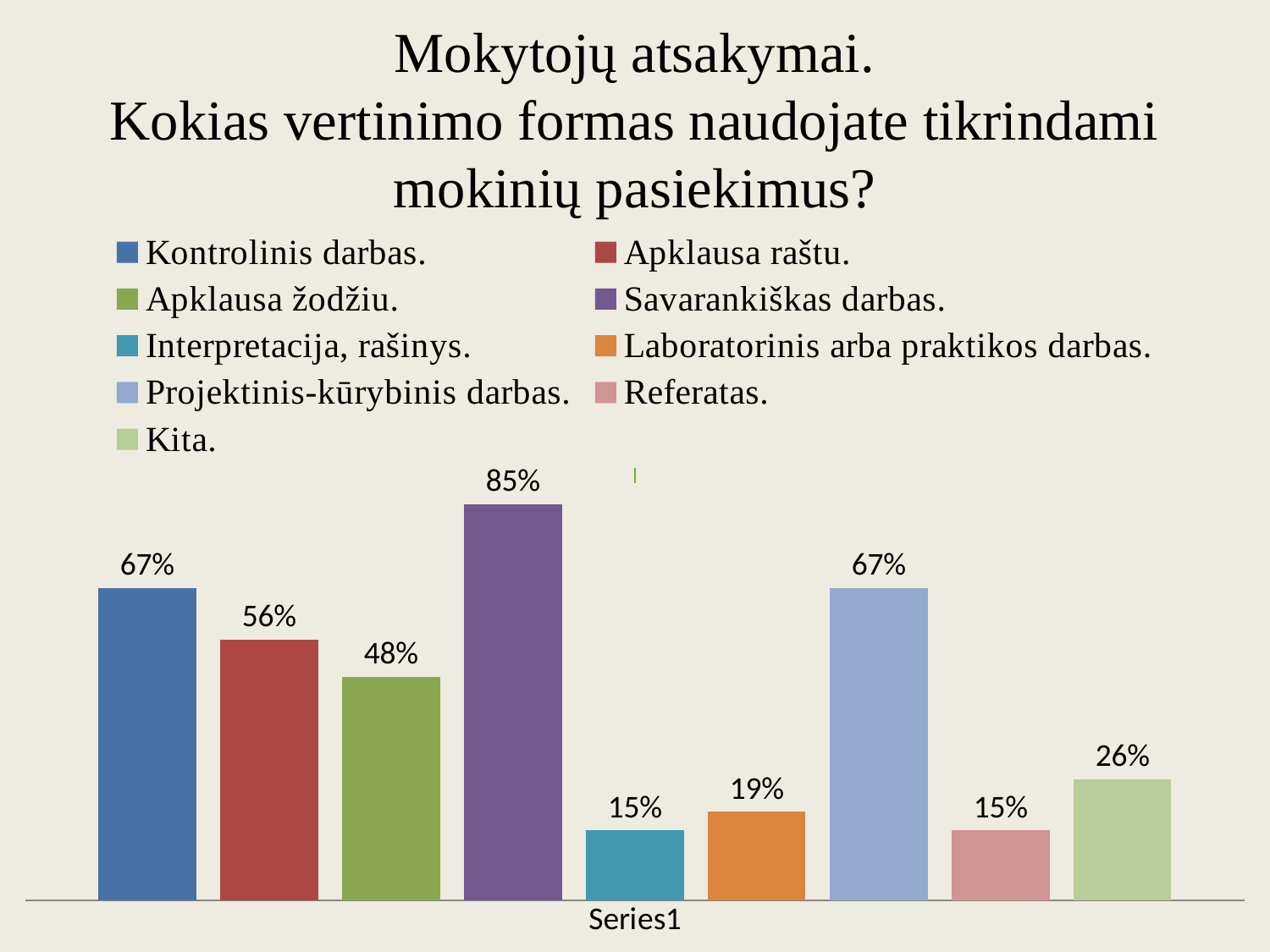
What percentage is shown for Apklausa raštu? 56% Which is larger, the value for Kita or the value for Referatas? Kita. Which assessment form has the highest percentage? Savarankiškas darbas. What is the difference between the percentages for Savarankiškas darbas and Kontrolinis darbas? 18% How many bars are plotted in the chart? 9 What is the difference between the percentages for Apklausa raštu and Apklausa žodžiu? 8% What percentage is shown for Savarankiškas darbas? 85% Which is larger, the value for Apklausa žodžiu or the value for Projektinis-kūrybinis darbas? Projektinis-kūrybinis darbas. What colour is the bar for Savarankiškas darbas? Purple What kind of chart is shown on the slide? Bar chart What percentage is shown for Kita? 26% What percentage is shown for Laboratorinis arba praktikos darbas? 19%